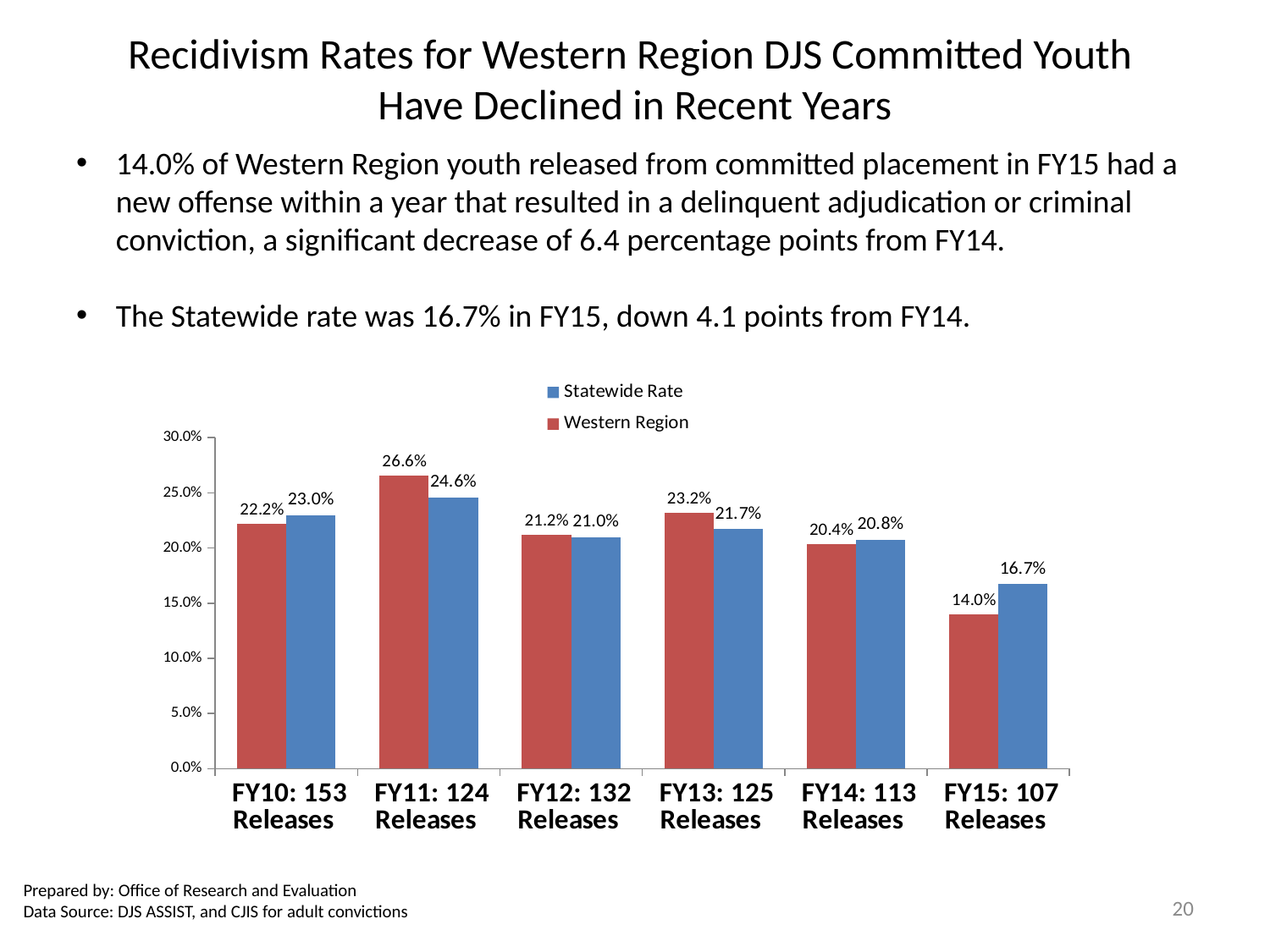
What kind of chart is shown on the slide? Bar chart What is the difference between the Western Region rates for FY14: 113 Releases and FY15: 107 Releases? 6.4 percentage points How many fiscal year categories are shown on the x axis? 6 Which fiscal year has the highest Western Region rate? FY11: 124 Releases How many series does the legend list? 2 What is the Western Region recidivism rate for FY15: 107 Releases? 14.0% Which fiscal year has the lowest Statewide Rate? FY15: 107 Releases Is the Western Region rate for FY11: 124 Releases greater or less than 25.0%? greater What is the difference between the Western Region rate and the Statewide Rate for FY15: 107 Releases? 2.7 percentage points What is the Statewide Rate for FY11: 124 Releases? 24.6% For FY13: 125 Releases, which is larger, the Western Region rate or the Statewide Rate? Western Region Which colour represents the Statewide Rate in the chart? Blue